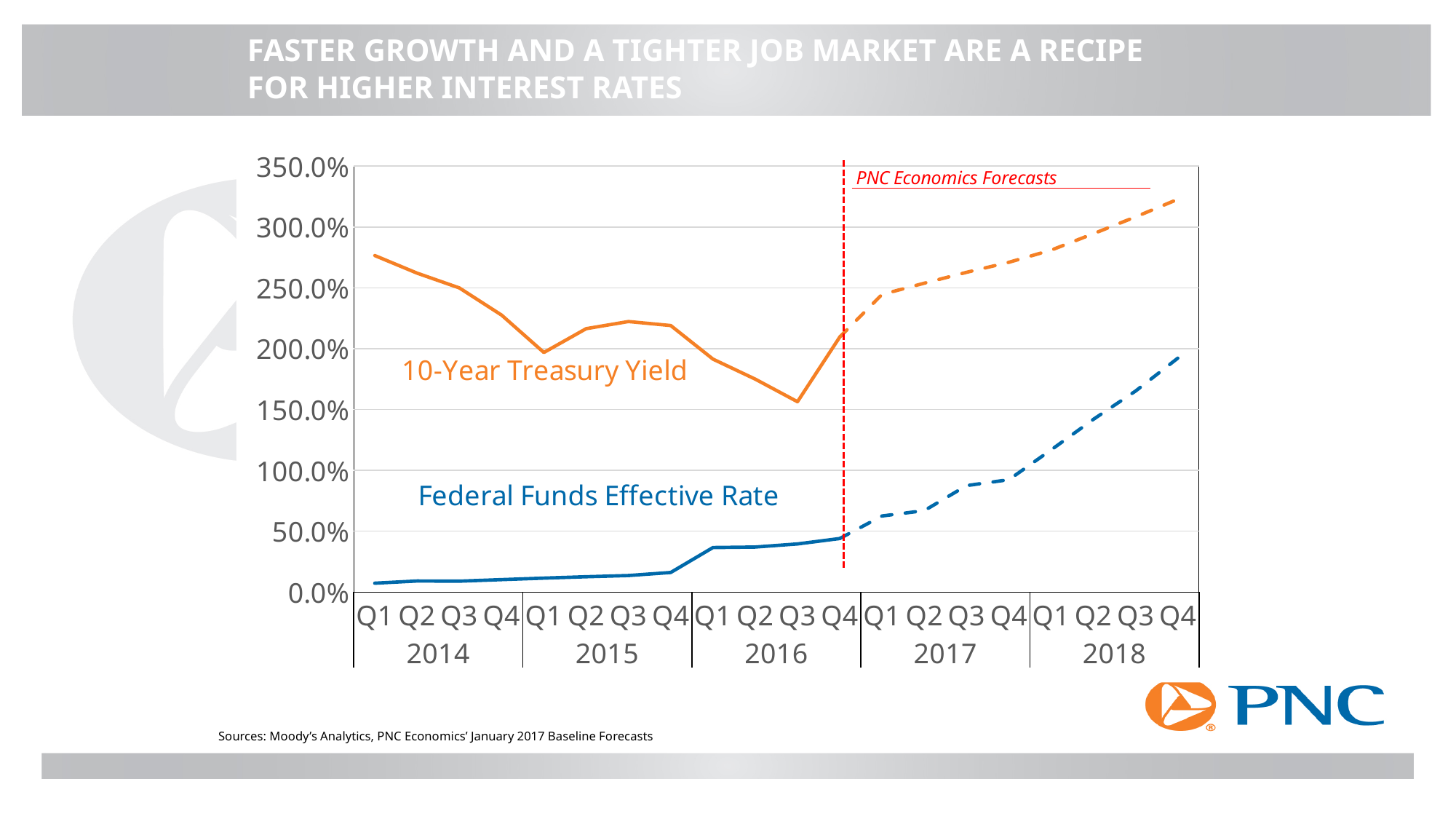
How many quarters are shown along the x axis of the chart? 20 How many data series are plotted on the chart? 2 Is the value for the 10-Year Treasury Yield in Q3 2016 greater or less than 200.0%? less Is the value for the Federal Funds Effective Rate in Q1 2014 greater or less than 50.0%? less Is the value for the 10-Year Treasury Yield in Q1 2014 greater or less than 250.0%? greater Does the Federal Funds Effective Rate rise or fall from Q1 2017 to Q4 2018? Rise What kind of chart is shown on the slide? Line chart Does the 10-Year Treasury Yield rise or fall from Q1 2014 to Q4 2014? Fall In which quarter does the 10-Year Treasury Yield reach its lowest point? Q3 2016 In Q1 2014, which series has the higher value, the 10-Year Treasury Yield or the Federal Funds Effective Rate? 10-Year Treasury Yield What does the red dashed vertical line on the chart mark the start of? PNC Economics Forecasts